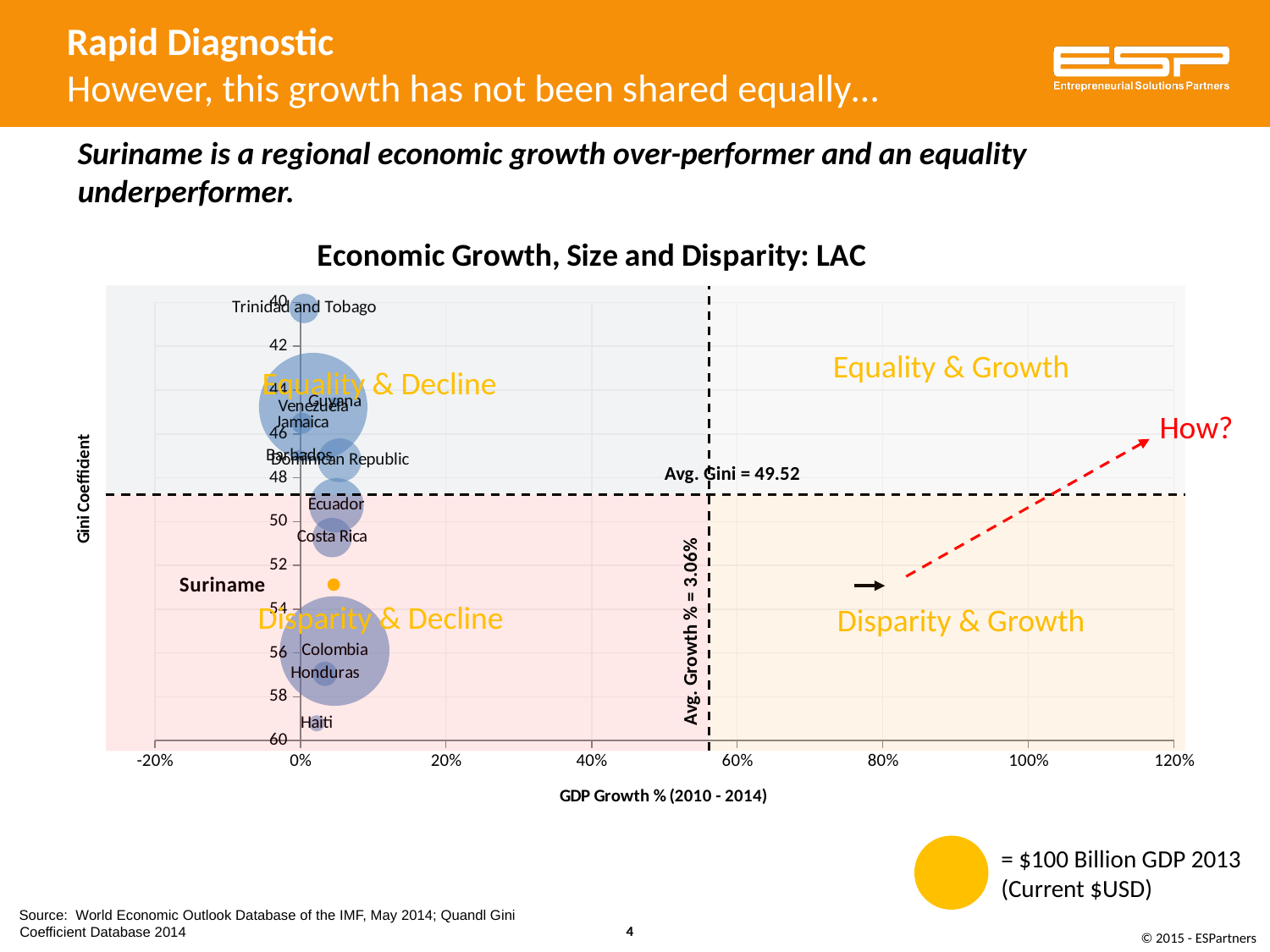
Is the Gini coefficient for Suriname greater or less than 52? greater What is the title of the chart? Economic Growth, Size and Disparity: LAC Which has the larger Gini coefficient, Haiti or Trinidad and Tobago? Haiti According to the legend, what does the bubble size represent? $100 Billion GDP 2013 (Current $USD) What is the average GDP growth % marked by the vertical dashed line? 3.06% Which country has the highest Gini coefficient on the chart? Haiti What kind of chart is shown on the slide? bubble chart How many countries are labelled on the chart? 12 Which country has the lowest Gini coefficient on the chart? Trinidad and Tobago What is the average Gini coefficient marked by the horizontal dashed line? 49.52 Is the Gini coefficient for Trinidad and Tobago greater or less than 42? less Is the GDP growth % for Suriname greater or less than 20%? less